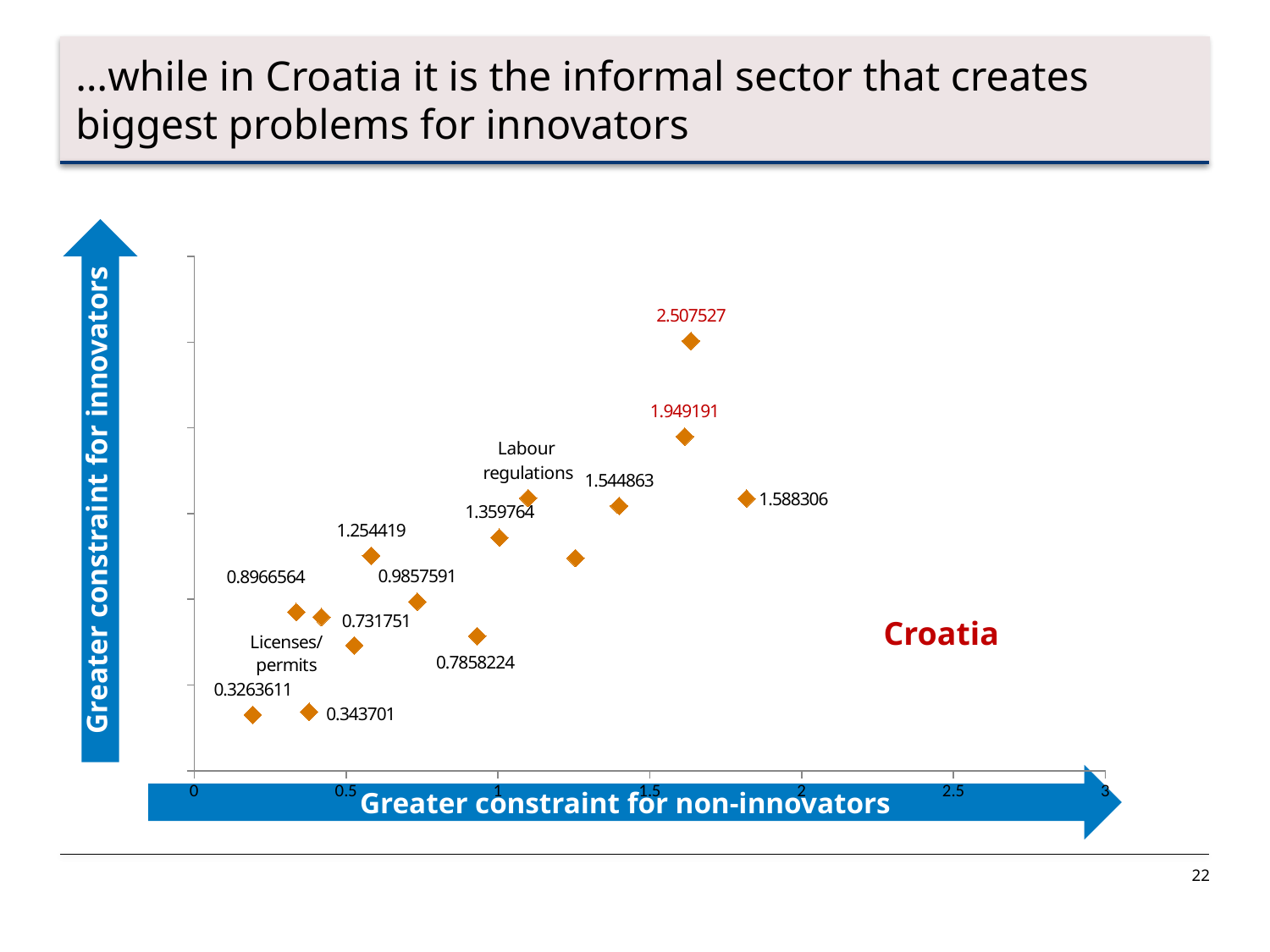
How many data points are plotted on the chart? 15 What is the difference between the two highest labelled values, 2.507527 and 1.949191? 0.558336 Is the horizontal-axis value of the point labelled 2.507527 greater or less than 1.5? greater What is the highest data label value shown on the chart? 2.507527 What is the lowest data label value shown on the chart? 0.3263611 What kind of chart is shown on the slide? scatter chart What is the largest tick value shown on the horizontal axis? 3 What is the label on the horizontal axis of the chart? Greater constraint for non-innovators Which is larger, the point labelled 1.949191 or the point labelled 1.588306? 1.949191 Do the plotted values generally rise or fall as you move from left to right along the horizontal axis? rise Which country does the chart refer to? Croatia Is the horizontal-axis value of the point labelled 0.3263611 greater or less than 0.5? less